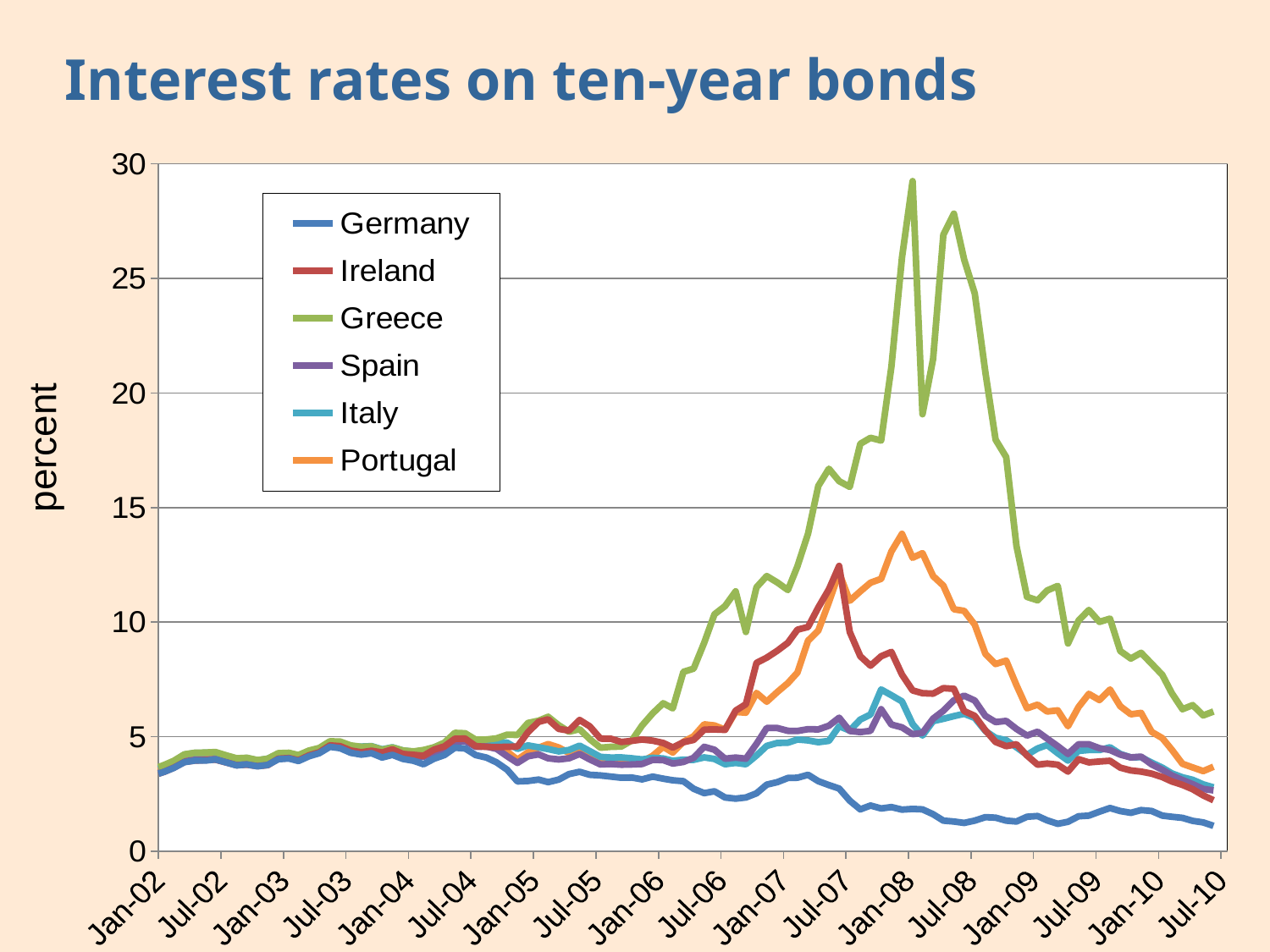
Which country's line reaches the highest value on the chart? Greece Which country has the lowest interest rate at Jul-10? Germany How many series does the legend list? 6 How many date labels are shown on the x axis? 18 Is the value for Germany at Jul-10 greater or less than 5? less What kind of chart is shown on the slide? line chart What is the label on the vertical axis? percent Is the peak value for Greece around Jan-08 greater or less than 25? greater Does the line for Germany rise or fall between Jan-07 and Jul-10? fall What is the title of the chart? Interest rates on ten-year bonds Is the peak value for Portugal around Jan-08 greater or less than 10? greater Which is higher at Jan-08, Greece or Germany? Greece